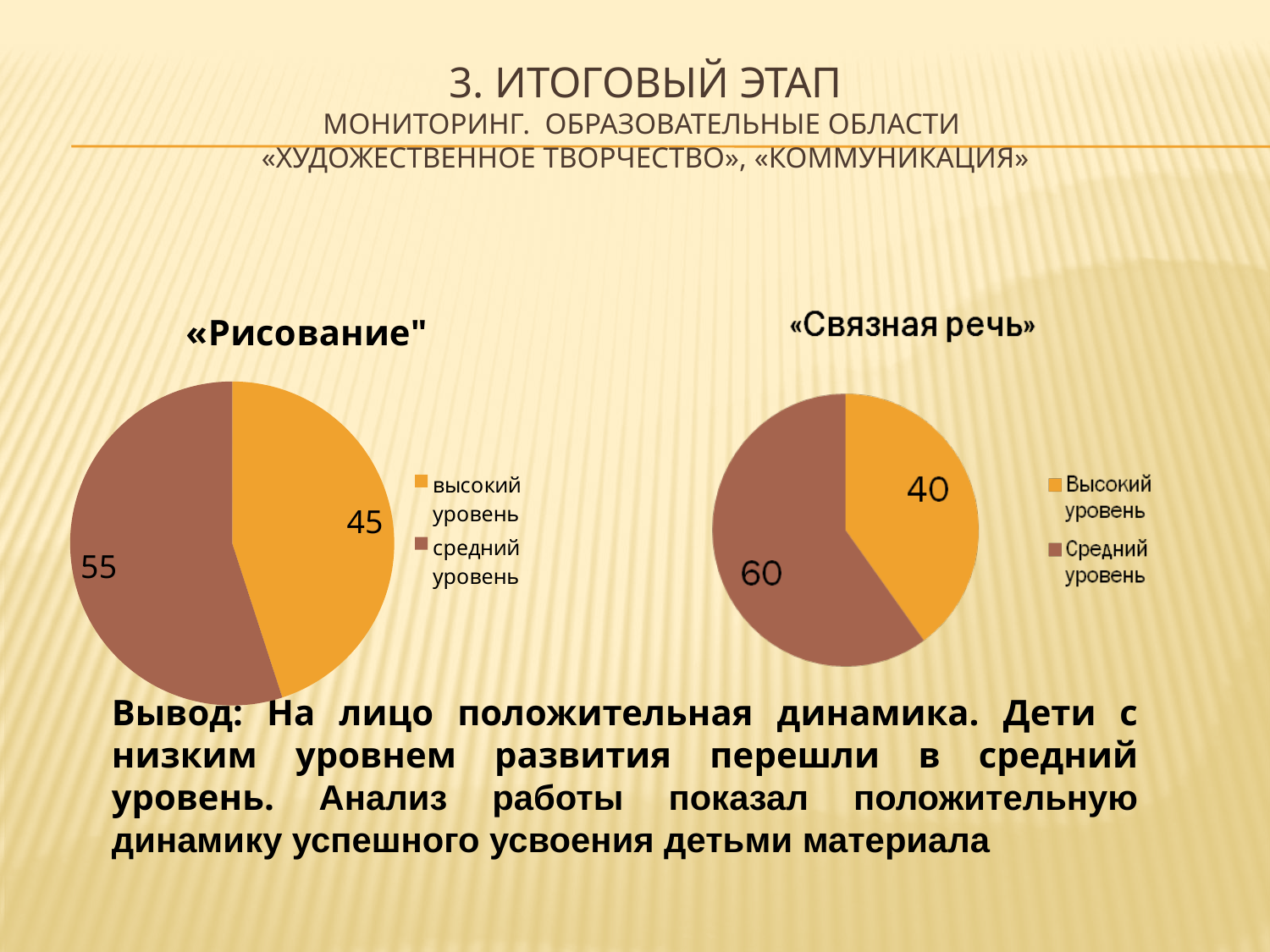
In the «Связная речь» chart, what share of the pie does Средний уровень take? 60% In the «Рисование» chart, what is the value for средний уровень? 55 In the «Связная речь» chart, what is the value for Высокий уровень? 40 Which is larger: высокий уровень in the «Рисование» chart or Высокий уровень in the «Связная речь» chart? высокий уровень in «Рисование» How many slices does the «Рисование» pie chart have? 2 In the «Связная речь» chart, which slice is the smallest? Высокий уровень In the «Связная речь» chart, what is the value for Средний уровень? 60 In the «Рисование» chart, which slice is the largest? средний уровень What type of chart is the «Связная речь» chart? Pie chart In the «Рисование» chart, what is the difference between средний уровень and высокий уровень? 10 In the «Рисование» chart, what is the value for высокий уровень? 45 In the «Связная речь» chart, what is the difference between Средний уровень and Высокий уровень? 20